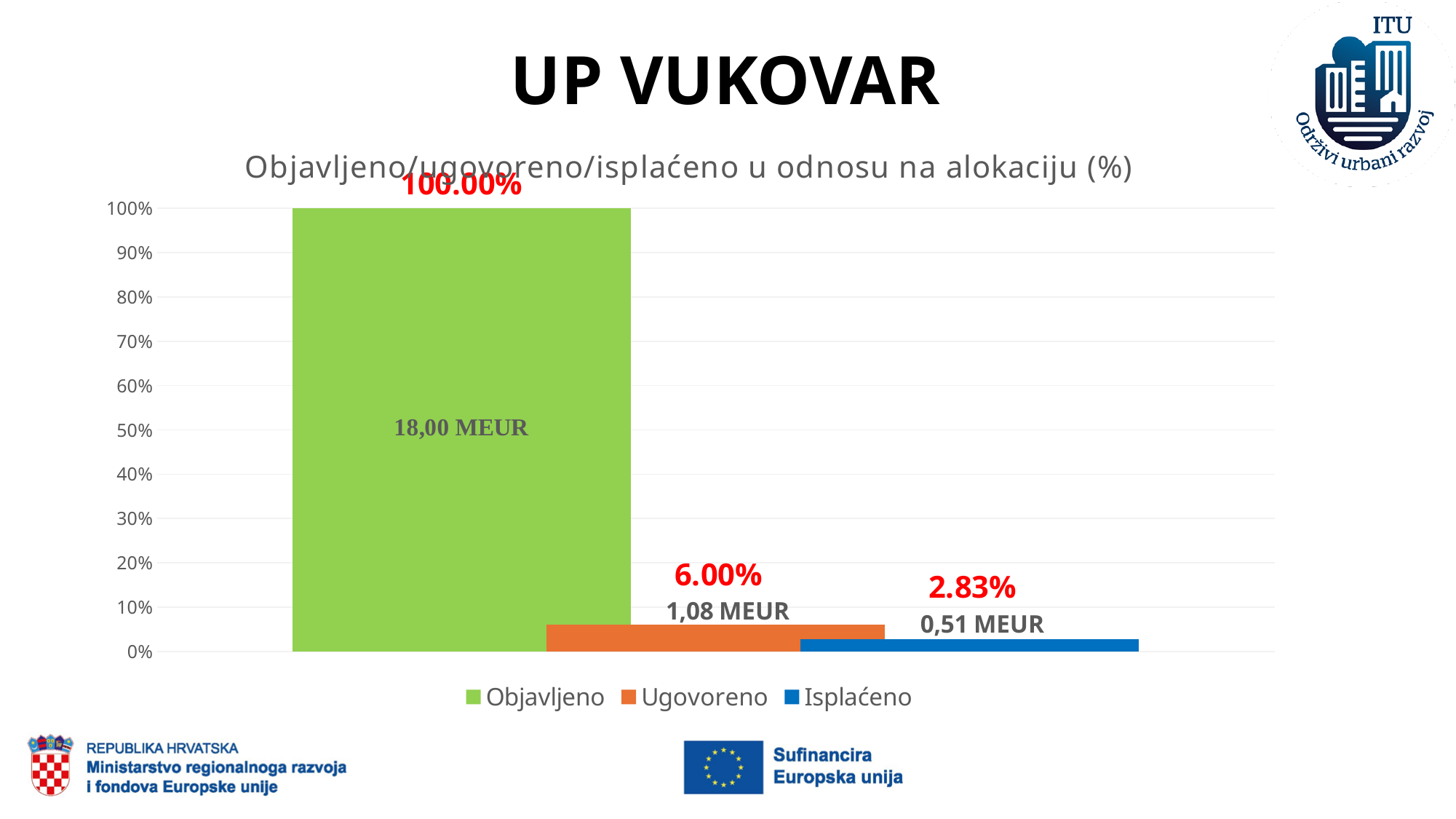
What is the value for Objavljeno? 100.00% What is the difference between the Ugovoreno and Isplaćeno percentages? 3.17% What amount in MEUR is shown for Isplaćeno? 0,51 MEUR Which is larger, Ugovoreno or Isplaćeno? Ugovoreno What is the value for Ugovoreno? 6.00% Which series has the highest value? Objavljeno Which series has the lowest value? Isplaćeno What amount in MEUR is shown for Ugovoreno? 1,08 MEUR What kind of chart is shown? Bar chart What is the title of the chart? Objavljeno/ugovoreno/isplaćeno u odnosu na alokaciju (%) What is the value for Isplaćeno? 2.83% How many series does the legend list? 3